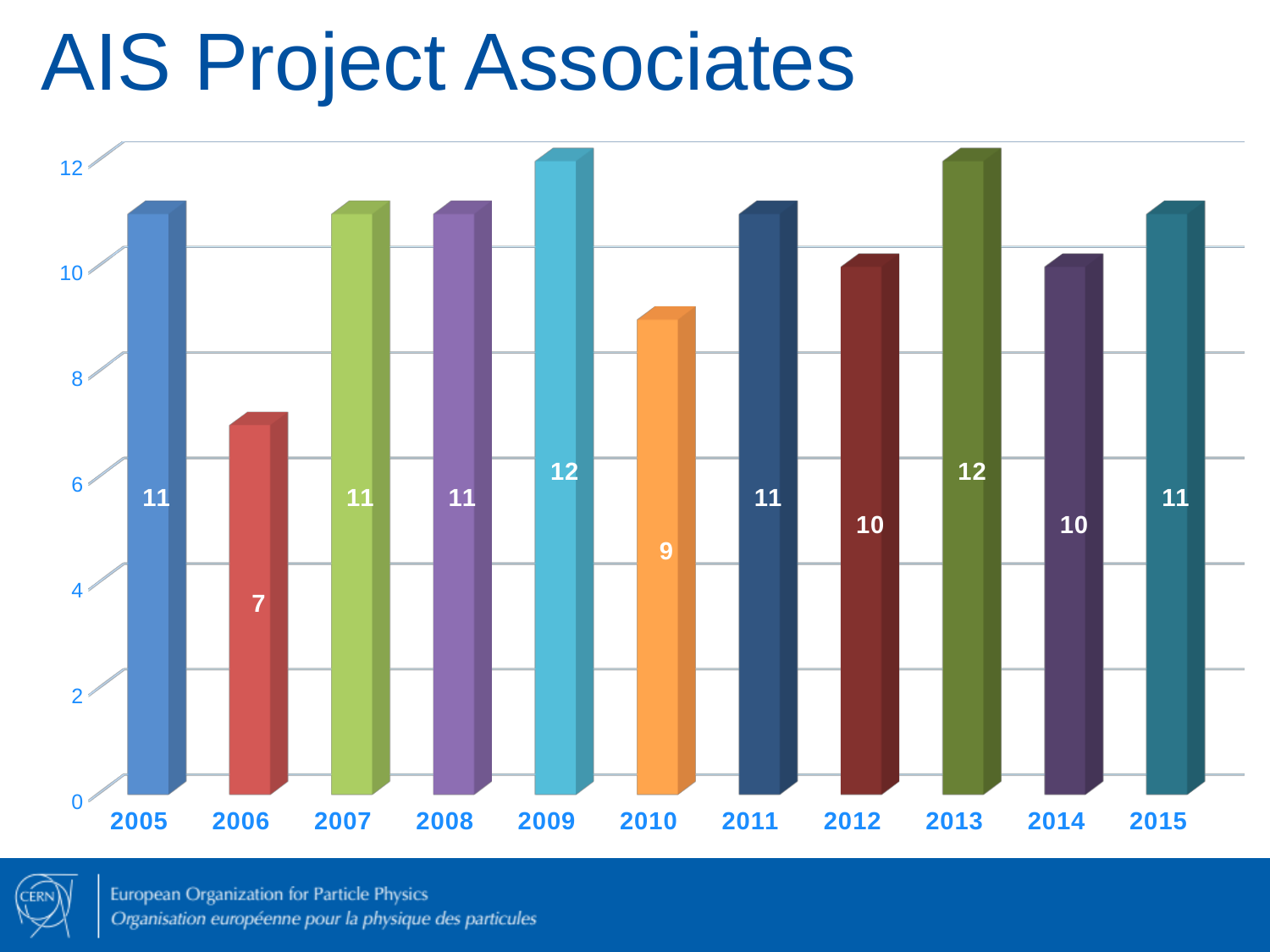
What is the difference between the values for 2012 and 2010? 1 What is the value for 2006? 7 Which is larger, the value for 2011 or the value for 2012? 2011 What is the value for 2013? 12 Is the value for 2006 greater or less than 8? less What is the title of the slide? AIS Project Associates What kind of chart is shown on the slide? bar chart What is the difference between the values for 2009 and 2006? 5 What is the value for 2014? 10 How many years are shown on the x axis? 11 What is the value for 2010? 9 Which year has the lowest value? 2006